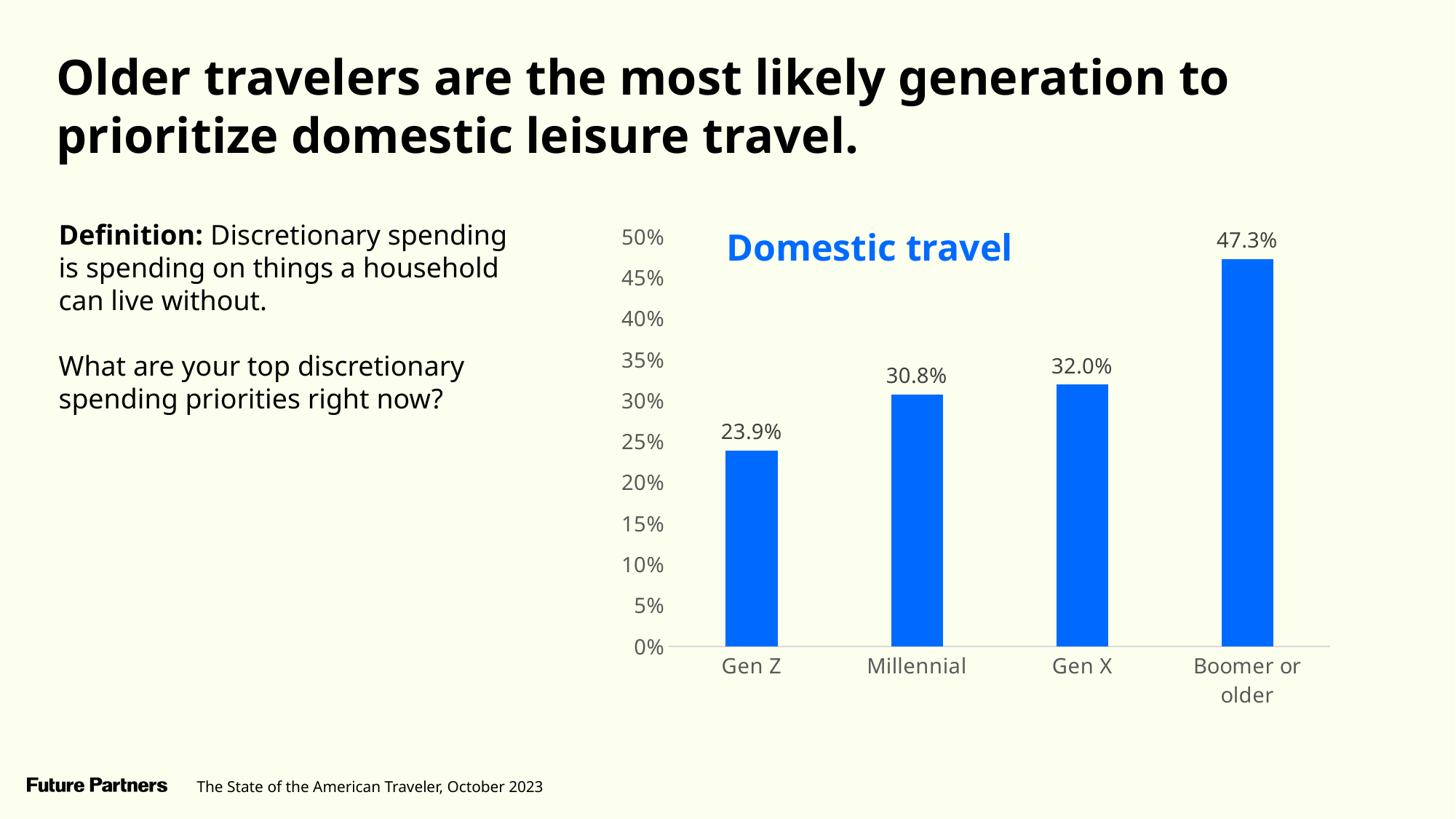
Which generation has the lowest value? Gen Z Which generation has the highest value? Boomer or older What is the difference between the values for Gen X and Millennial? 1.2% What is the difference between the values for Boomer or older and Gen Z? 23.4% What is the value for Gen X? 32.0% How many generations are shown on the chart? 4 What is the value for Millennial? 30.8% What kind of chart is shown on the slide? Bar chart What is the value for Boomer or older? 47.3% Which is larger, the value for Millennial or the value for Boomer or older? Boomer or older What is the value for Gen Z? 23.9% What is the title of the chart? Domestic travel